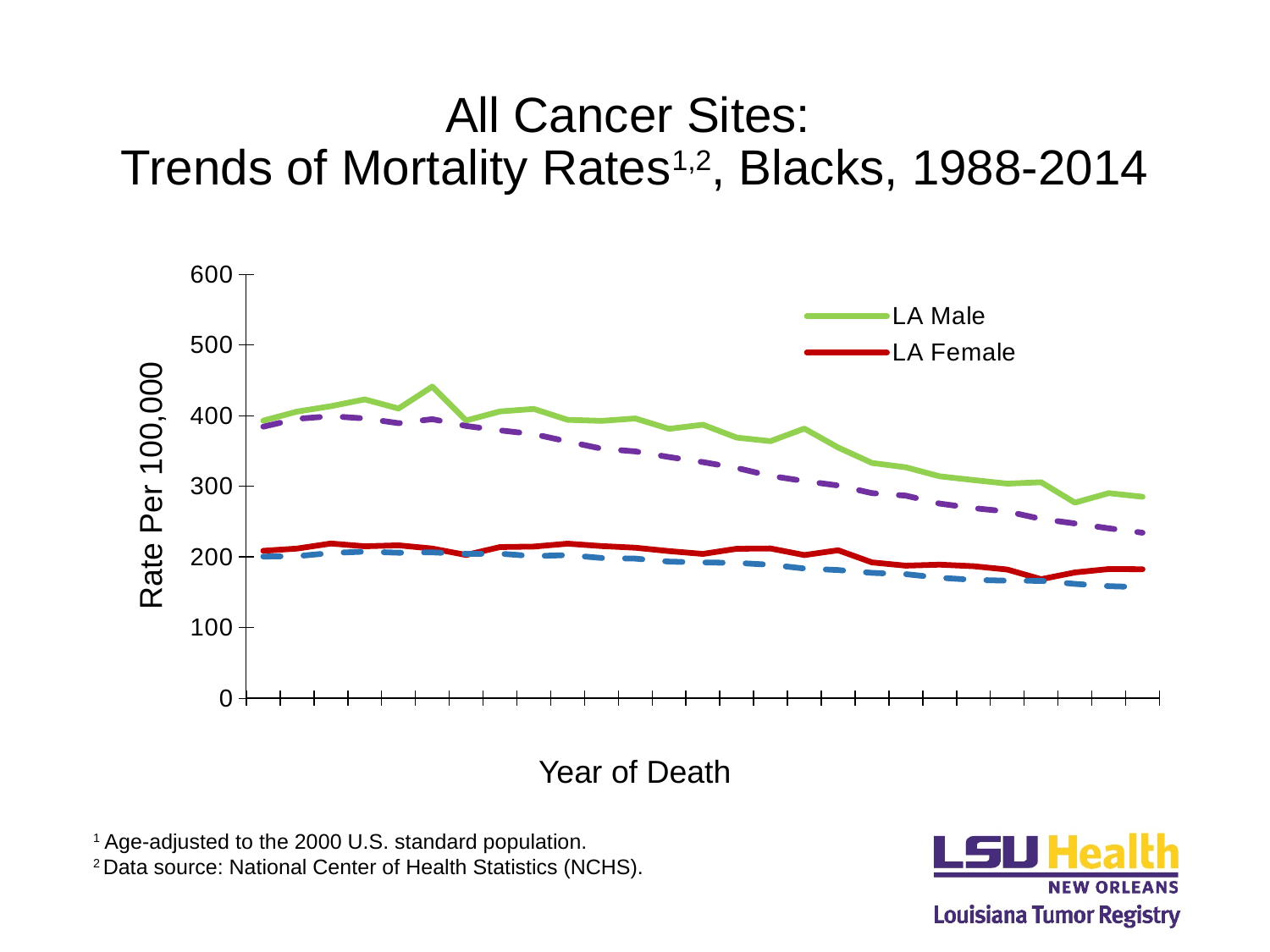
Is the LA Female rate at the end of the series (2014) greater or less than 200? less Does the LA Female mortality rate rise or fall overall across the years shown? Fall Does the LA Male mortality rate rise or fall overall from 1988 to 2014? Fall Is the LA Male rate at the end of the series (2014) greater or less than 300? less Is the highest LA Male rate on the chart greater or less than 500? less Which two series are named in the legend? LA Male and LA Female What is the label on the y-axis of the chart? Rate Per 100,000 How many series does the chart's legend list? 2 What kind of chart is shown on the slide? Line chart Which series has the higher mortality rate throughout the chart, LA Male or LA Female? LA Male